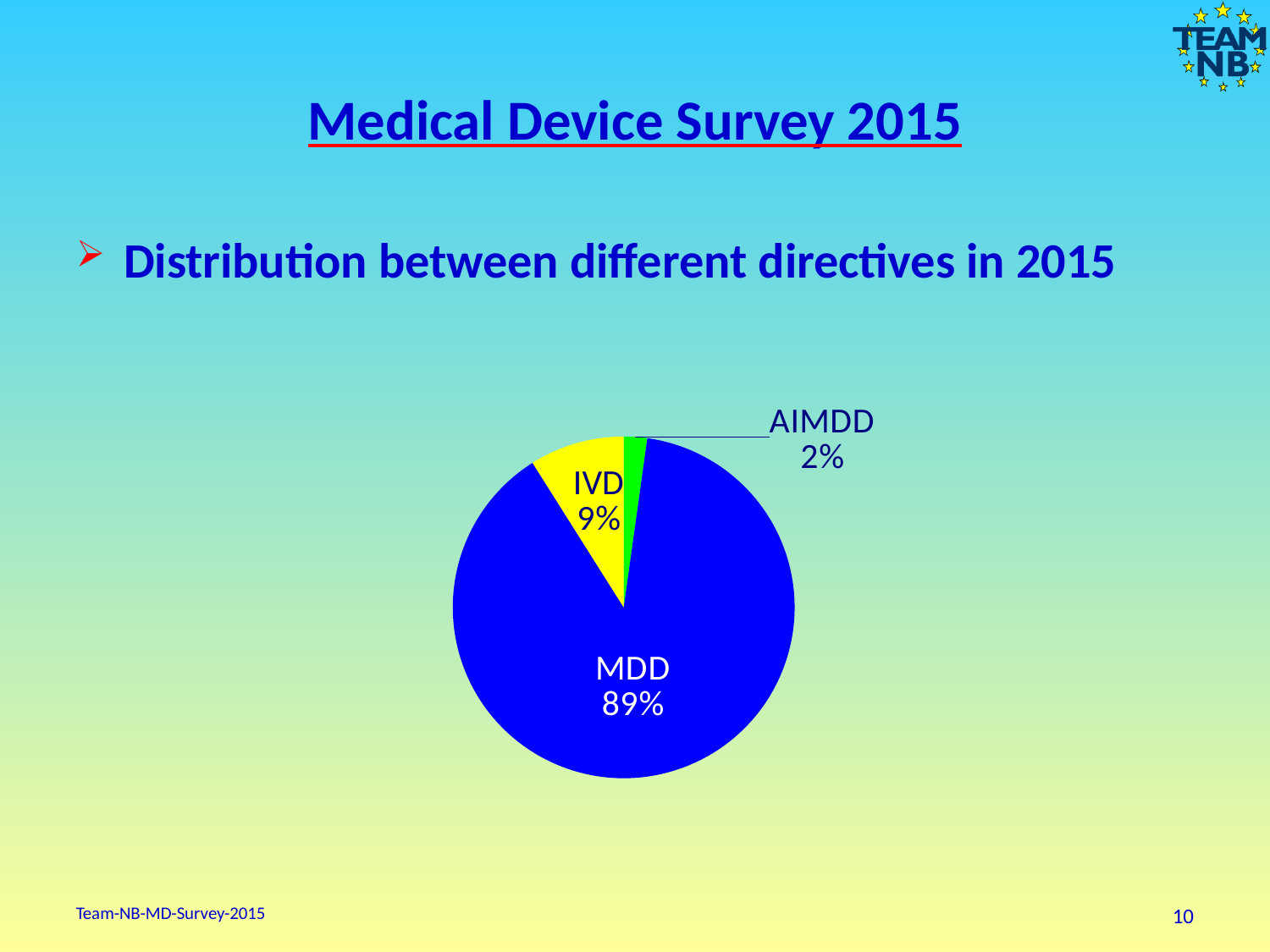
What is the difference in percentage points between the MDD and IVD shares? 80 What is the difference in percentage points between the IVD and AIMDD shares? 7 Which directive has the smallest share of the pie? AIMDD What colour is the MDD slice of the pie? blue Which directive has the largest share of the pie? MDD What share of the pie does AIMDD represent? 2% Which has a larger share, IVD or AIMDD? IVD What share of the pie does MDD represent? 89% What colour is the IVD slice of the pie? yellow How many slices does the pie chart have? 3 What kind of chart is shown on the slide? pie chart What share of the pie does IVD represent? 9%